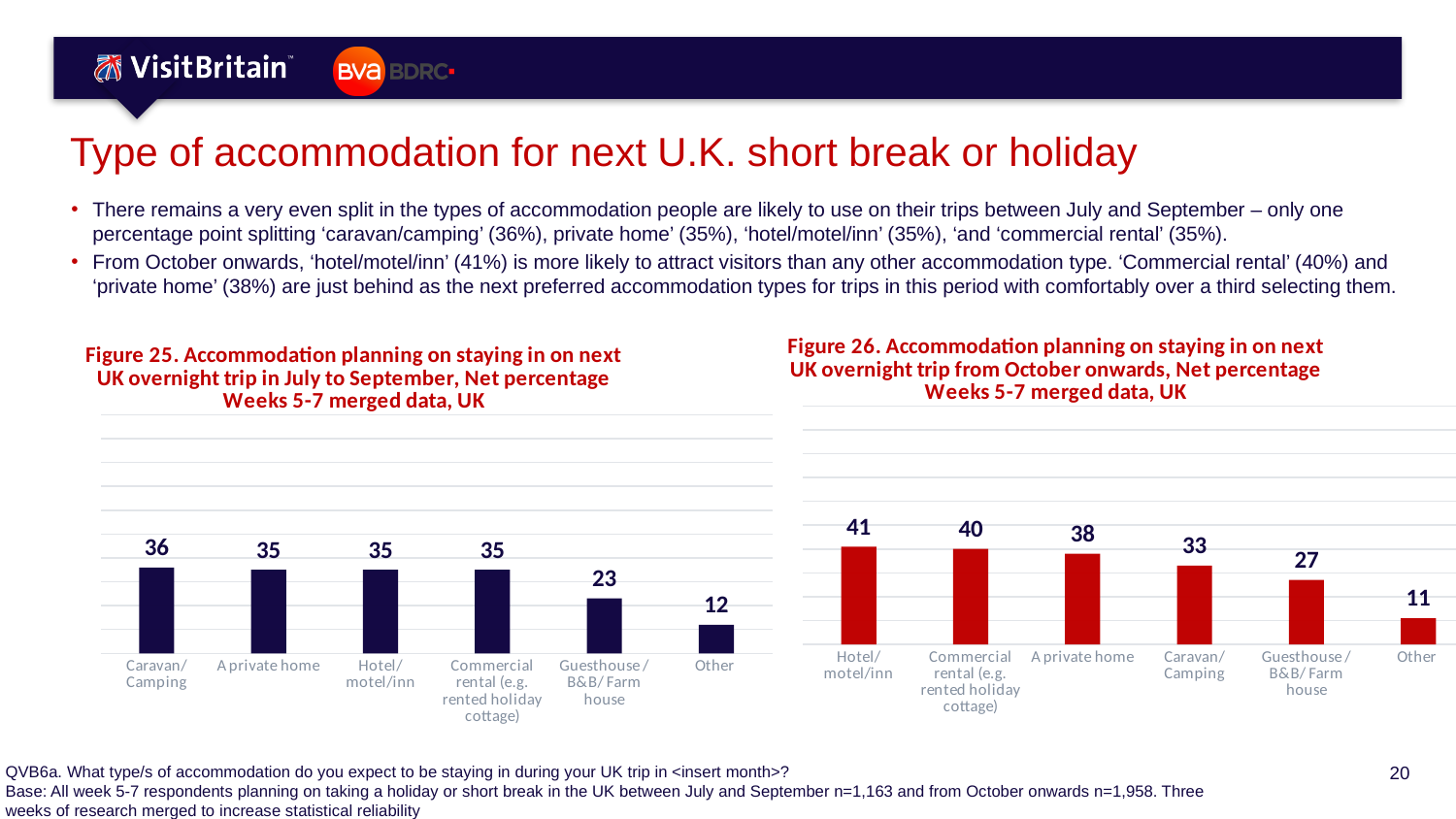
In the Figure 26 chart (October onwards), which category has the lowest value? Other In the Figure 25 chart (July to September), what is the value for Guesthouse/B&B/Farm house? 23 In the Figure 26 chart (October onwards), what is the value for Hotel/motel/inn? 41 In the Figure 26 chart (October onwards), which is larger: A private home or Guesthouse/B&B/Farm house? A private home What type of chart is the Figure 26 chart (October onwards)? Bar chart In the Figure 25 chart (July to September), what is the difference between Caravan/Camping and Other? 24 What colour are the bars in the Figure 25 chart (July to September)? Dark navy blue In the Figure 25 chart (July to September), what is the value for Caravan/Camping? 36 In the Figure 26 chart (October onwards), do the values rise or fall from left to right? Fall In the Figure 26 chart (October onwards), what is the difference between Hotel/motel/inn and Caravan/Camping? 8 In the Figure 25 chart (July to September), which category has the highest value? Caravan/Camping How many categories are shown in the Figure 25 chart (July to September)? 6